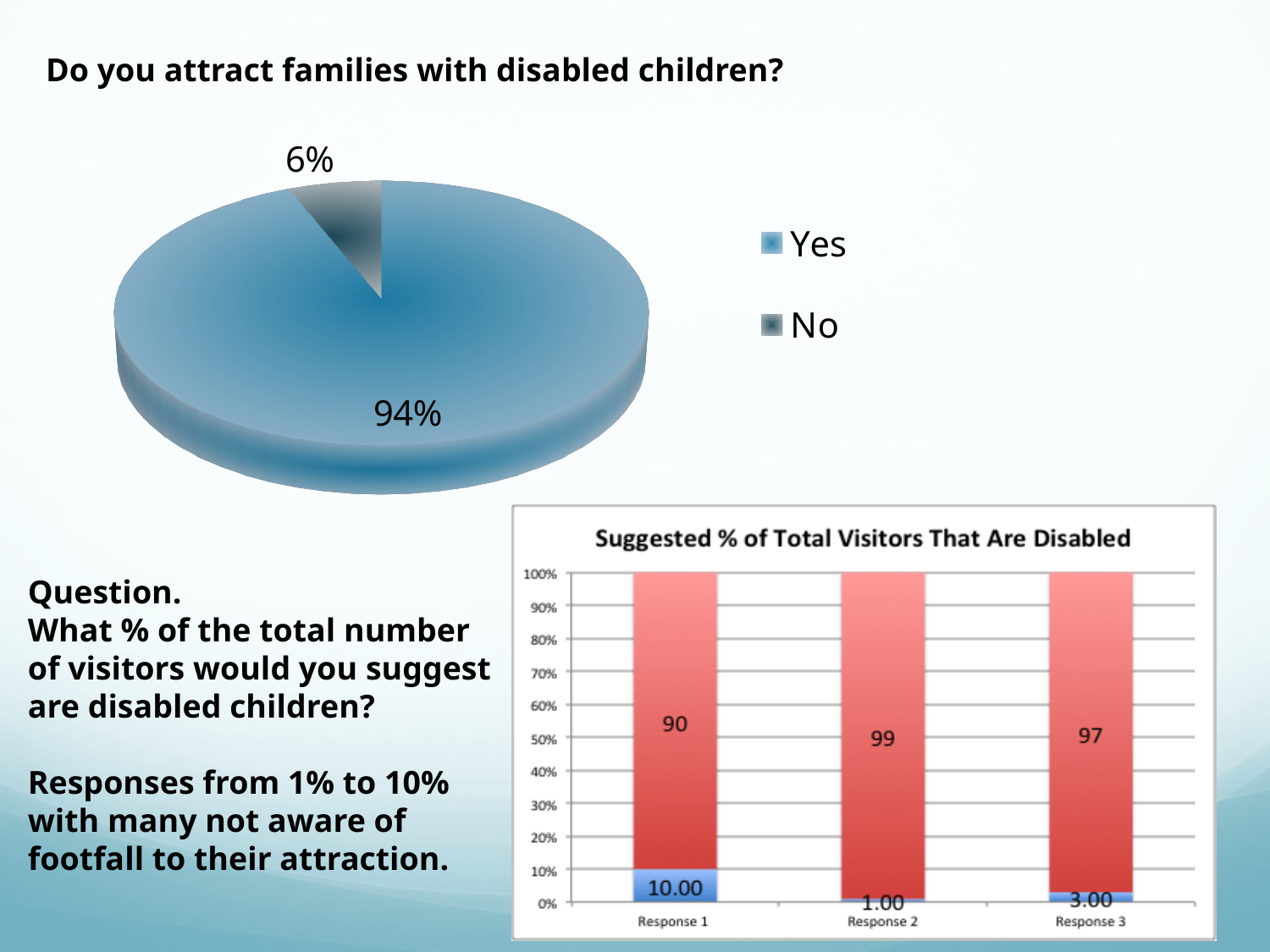
In the chart 'Suggested % of Total Visitors That Are Disabled', which response has the lowest blue segment value? Response 2 In the chart 'Suggested % of Total Visitors That Are Disabled', what is the difference between the red segment values for Response 2 and Response 1? 9 How many entries does the legend of the pie chart list? 2 In the chart 'Suggested % of Total Visitors That Are Disabled', what is the value of the red segment for Response 2? 99 What kind of chart is the chart at the top left of the slide? Pie chart In the pie chart, which response has the larger share, Yes or No? Yes In the chart 'Suggested % of Total Visitors That Are Disabled', what is the value of the blue segment for Response 3? 3.00 In the chart 'Suggested % of Total Visitors That Are Disabled', what is the value of the blue segment for Response 1? 10.00 What kind of chart is the chart titled 'Suggested % of Total Visitors That Are Disabled'? Bar chart In the pie chart, what share of respondents answered No? 6% In the pie chart, what share of respondents answered Yes? 94% In the chart 'Suggested % of Total Visitors That Are Disabled', how many responses are shown on the x axis? 3